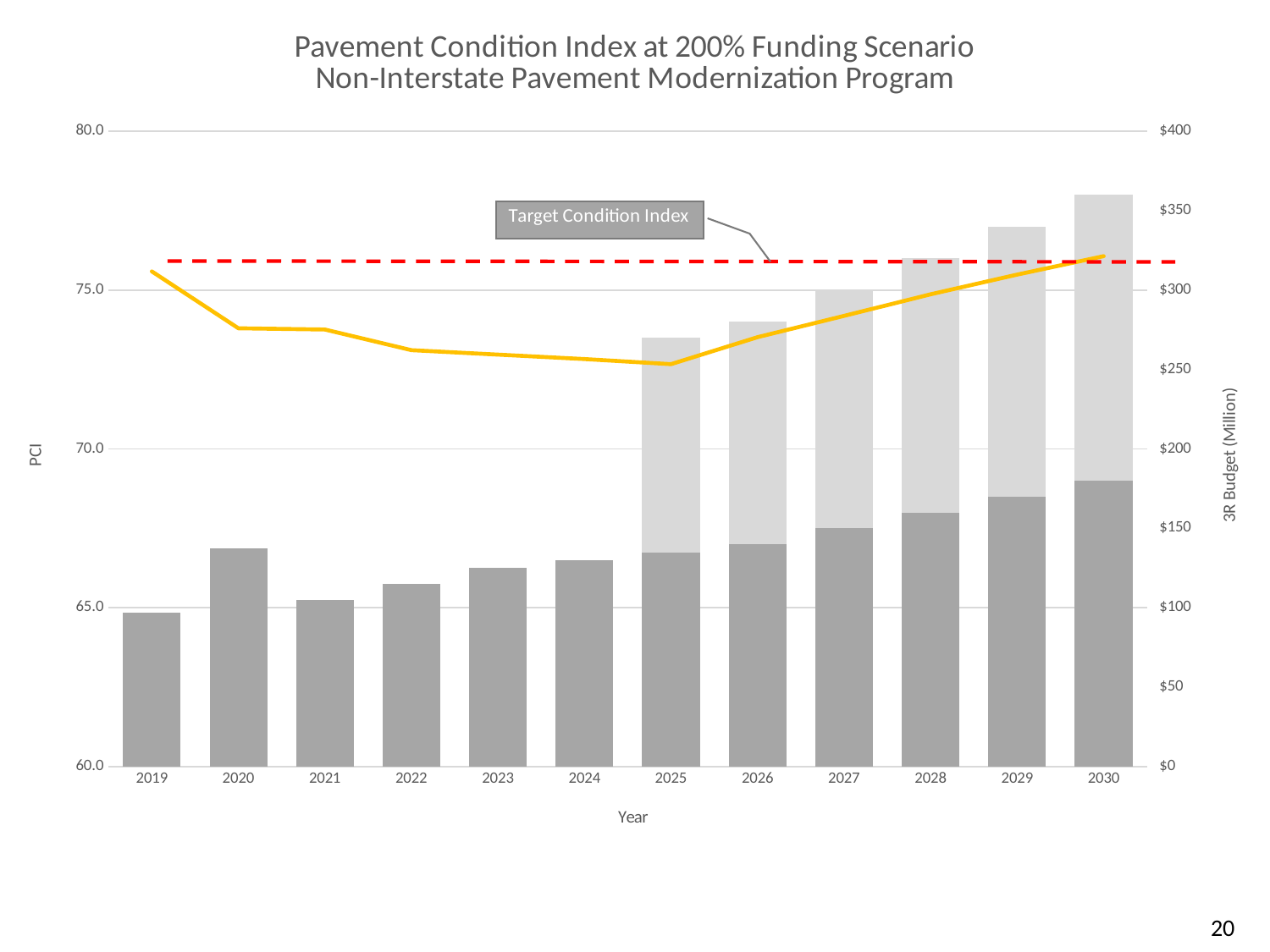
Which year has the tallest stacked bar? 2030 Is the total height of the stacked bar for 2030 greater or less than $300? greater Is the dark gray bar for 2030 taller than the dark gray bar for 2019? Yes Which year has the shortest dark gray bar? 2019 How many years are shown along the x axis? 12 Is the yellow PCI line value for 2025 greater or less than 75.0? less What kind of chart is shown on the slide? A combined bar and line chart What is the label of the right-hand vertical axis? 3R Budget (Million) Does the yellow PCI line rise or fall from 2025 to 2030? rises Is the dark gray bar for 2020 greater or less than $150? less In which year does the yellow PCI line reach its lowest point? 2025 What is the title of the chart? Pavement Condition Index at 200% Funding Scenario Non-Interstate Pavement Modernization Program